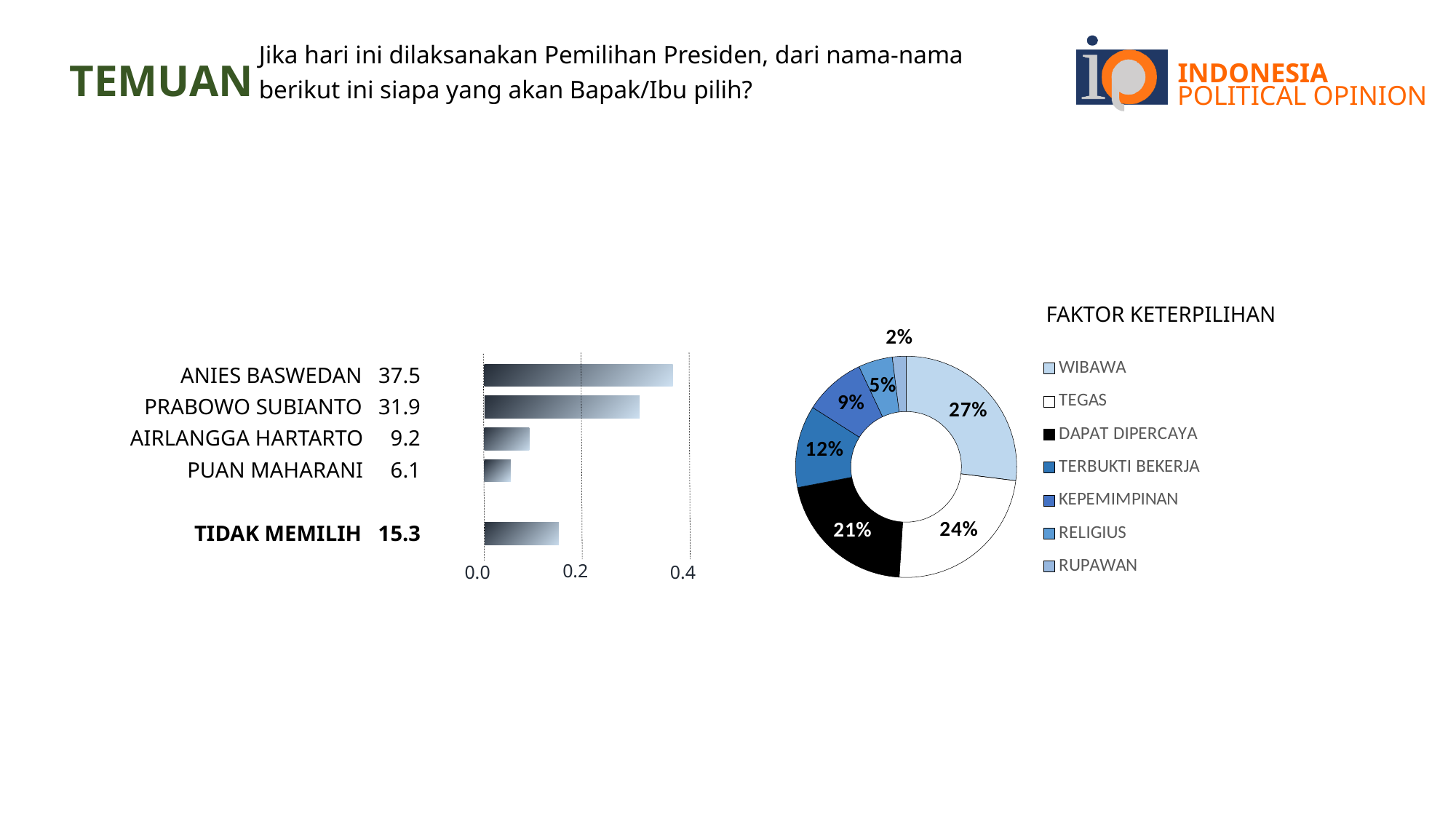
In the FAKTOR KETERPILIHAN chart, what is the value for DAPAT DIPERCAYA? 21% What kind of chart is the chart on the left of the slide? Bar chart How many factors does the legend of the FAKTOR KETERPILIHAN chart list? 7 In the bar chart on the left, what is the value for ANIES BASWEDAN? 37.5 In the FAKTOR KETERPILIHAN chart, what is the difference between the shares for TEGAS and KEPEMIMPINAN? 15% In the bar chart on the left, which is larger: the value for AIRLANGGA HARTARTO or the value for TIDAK MEMILIH? TIDAK MEMILIH In the FAKTOR KETERPILIHAN chart, which factor has the smallest share? RUPAWAN In the bar chart on the left, which candidate has the highest value? ANIES BASWEDAN In the FAKTOR KETERPILIHAN chart, what share does WIBAWA have? 27% In the bar chart on the left, what is the difference between the values for ANIES BASWEDAN and PRABOWO SUBIANTO? 5.6 In the bar chart on the left, which category has the lowest value? PUAN MAHARANI In the bar chart on the left, what is the value for TIDAK MEMILIH? 15.3